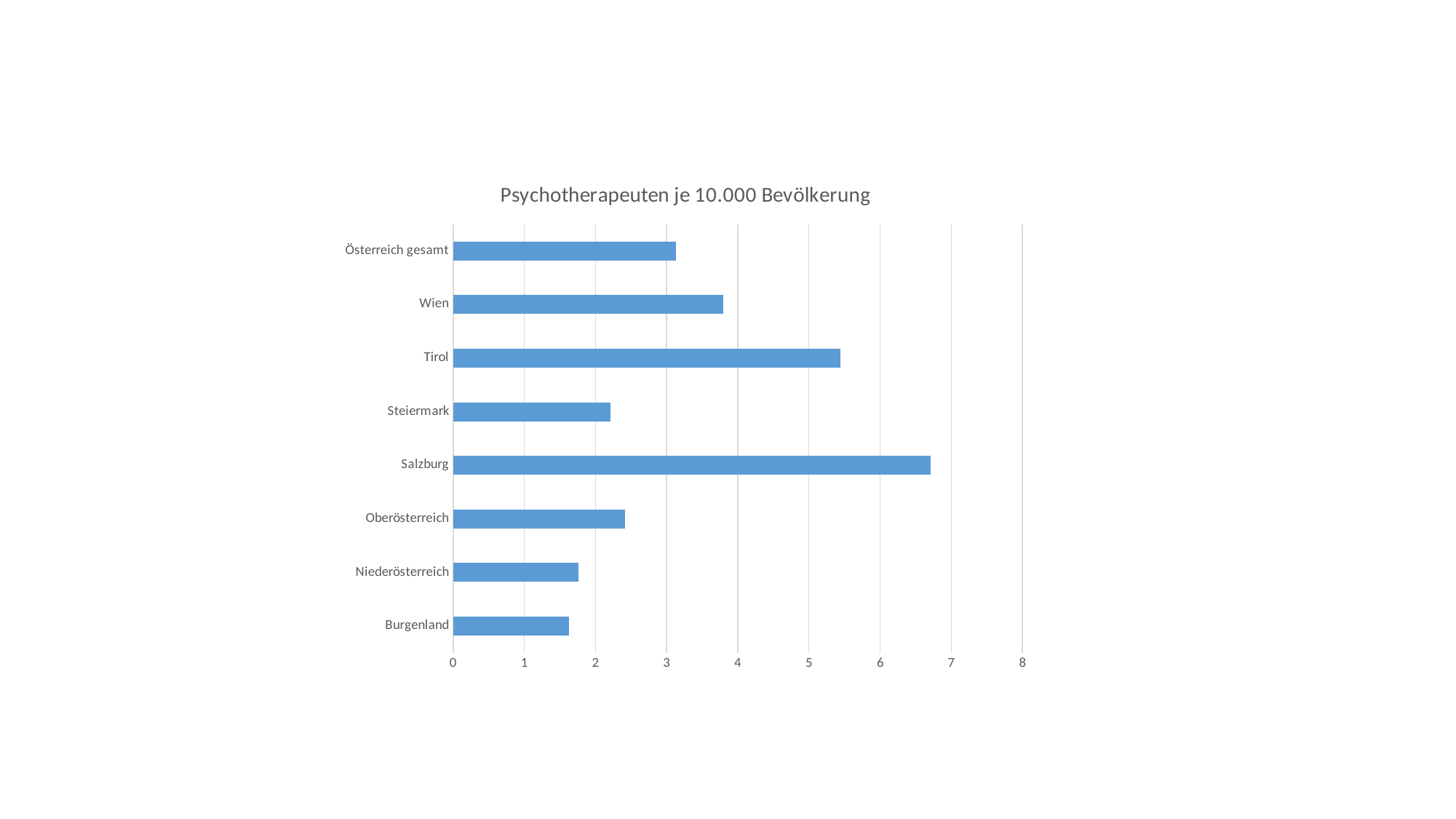
Which has a larger value, Steiermark or Salzburg? Salzburg What is the title of the chart? Psychotherapeuten je 10.000 Bevölkerung Is the value for Österreich gesamt greater or less than 3? greater What kind of chart is shown on the slide? Bar chart Is the value for Wien greater or less than 4? less Is the value for Salzburg greater or less than 6? greater Which has a larger value, Tirol or Wien? Tirol How many categories are plotted in the chart? 8 Which category has the highest value? Salzburg